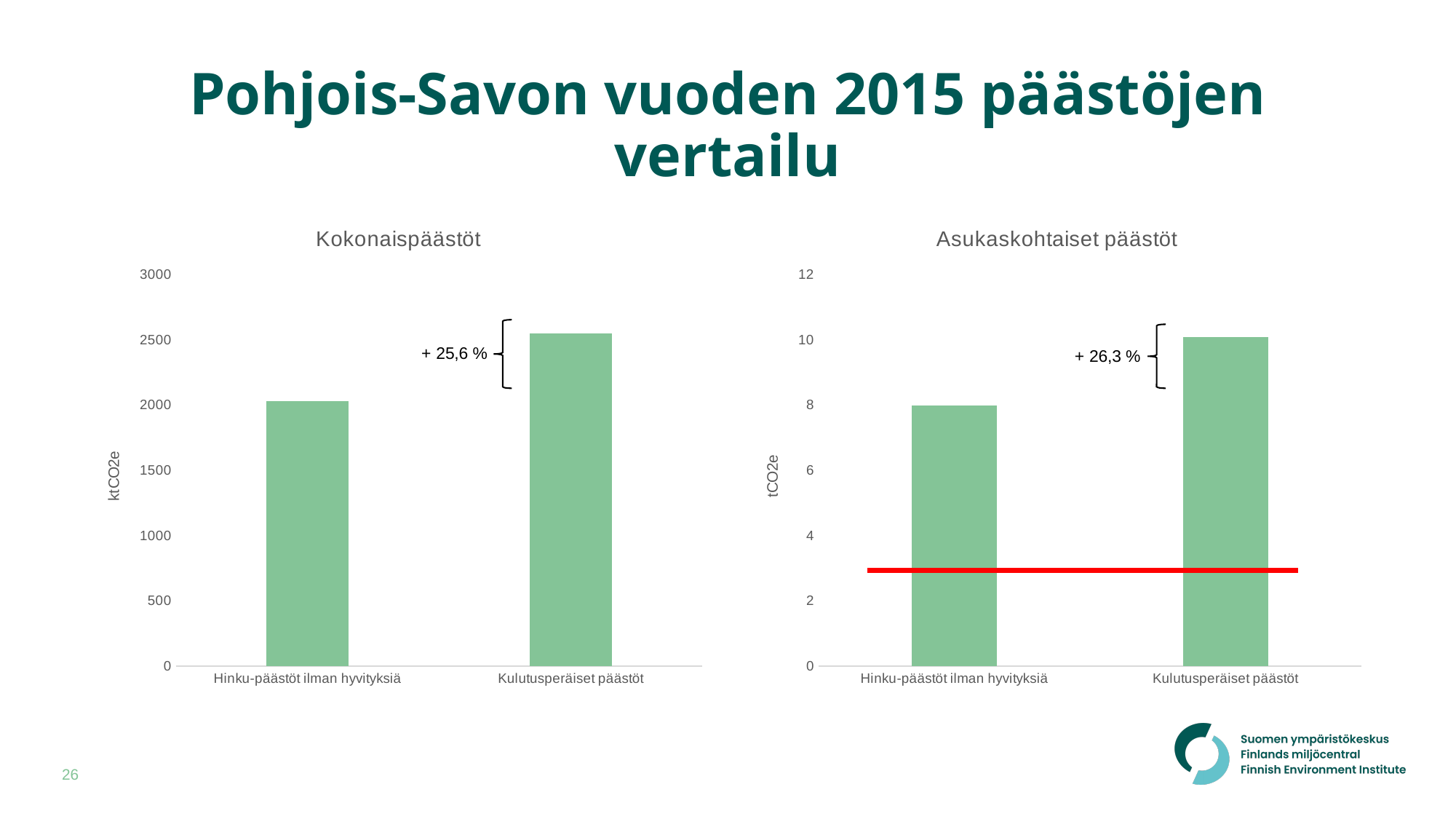
In the Asukaskohtaiset päästöt chart, is the value for Hinku-päästöt ilman hyvityksiä greater or less than 6? greater What unit is shown on the y axis of the Kokonaispäästöt chart? ktCO2e How many bars does the Kokonaispäästöt chart show? 2 In the Kokonaispäästöt chart, is the value for Kulutusperäiset päästöt greater or less than 3000? less In the Kokonaispäästöt chart, is the value for Hinku-päästöt ilman hyvityksiä greater or less than 1500? greater In the Kokonaispäästöt chart, which category has the higher value? Kulutusperäiset päästöt In the Asukaskohtaiset päästöt chart, which category has the lower value? Hinku-päästöt ilman hyvityksiä What percentage increase is annotated between the two bars in the Asukaskohtaiset päästöt chart? + 26,3 % What kind of chart is the Kokonaispäästöt chart? bar chart